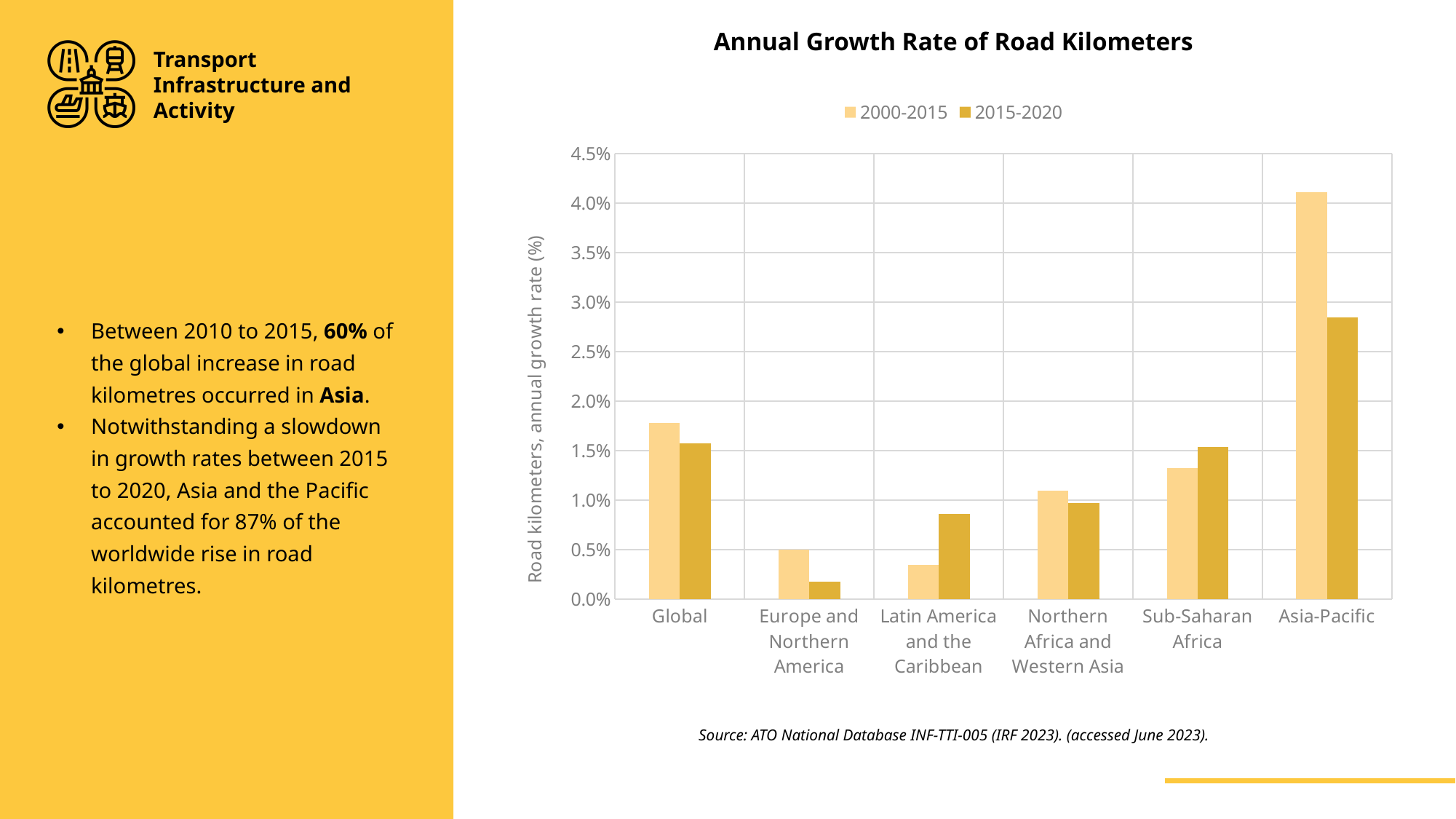
Is the 2000-2015 value for Asia-Pacific greater or less than 3.5%? greater Which category has the highest value for the 2000-2015 series? Asia-Pacific For Global, which series has the larger value, 2000-2015 or 2015-2020? 2000-2015 Is the 2015-2020 value for Asia-Pacific greater or less than 3.0%? less Is the 2015-2020 value for Europe and Northern America greater or less than 0.5%? less How many regional categories are shown on the x axis of the chart? 6 Which category has the lowest value for the 2015-2020 series? Europe and Northern America What type of chart is shown on the slide? Bar chart How many series does the chart legend list? 2 What is the title of the chart? Annual Growth Rate of Road Kilometers Which category has the lowest value for the 2000-2015 series? Latin America and the Caribbean For Latin America and the Caribbean, which series has the larger value, 2000-2015 or 2015-2020? 2015-2020